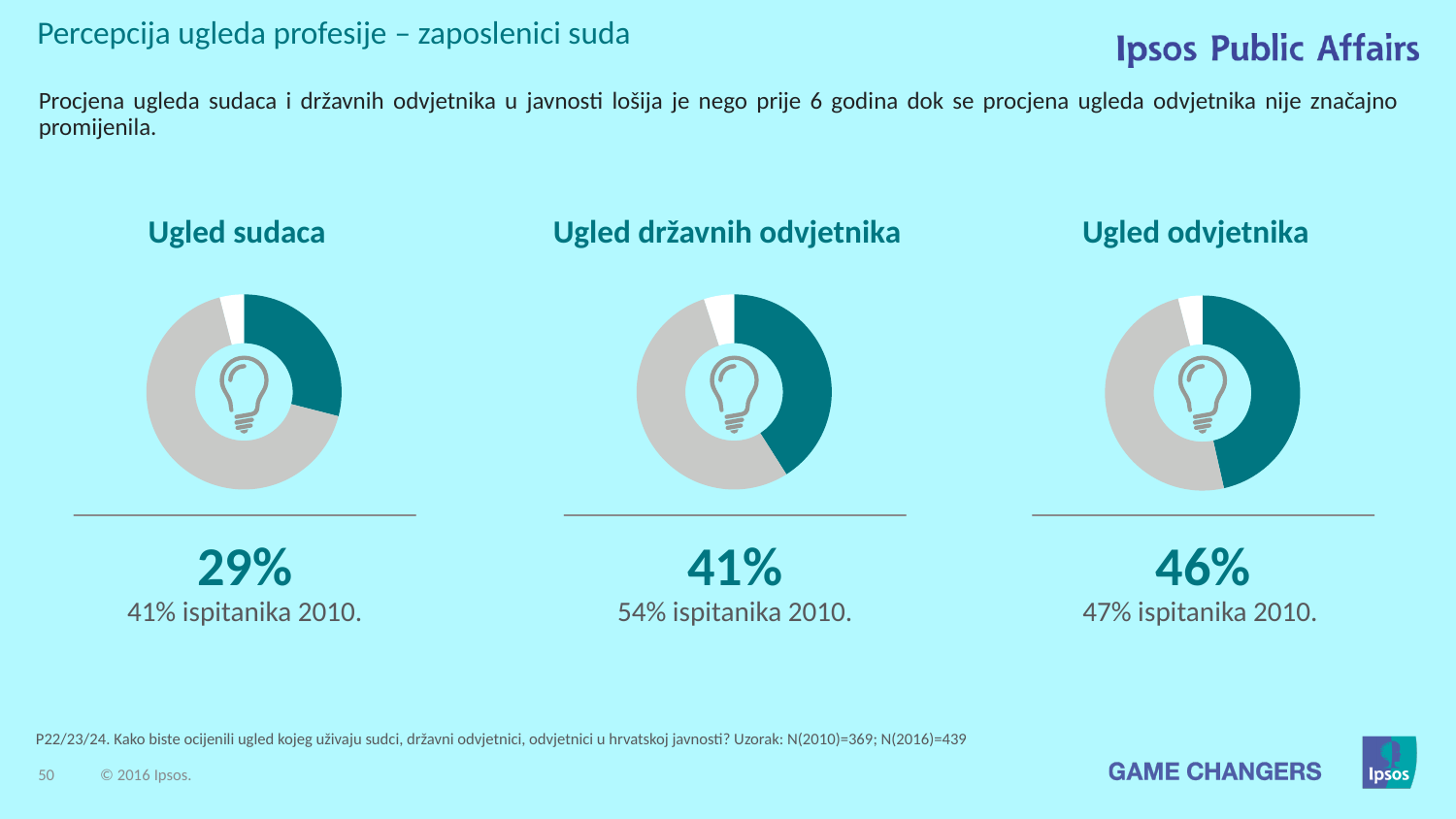
In the 'Ugled državnih odvjetnika' chart, what percentage is shown as the main value? 41% In the 'Ugled sudaca' chart, what was the percentage of respondents in 2010? 41% In the 'Ugled odvjetnika' chart, what was the percentage of respondents in 2010? 47% In the 'Ugled odvjetnika' chart, what percentage is shown as the main value? 46% Which of the three charts shows the highest main percentage? Ugled odvjetnika In the 'Ugled državnih odvjetnika' chart, what was the percentage of respondents in 2010? 54% Which of the three charts shows the lowest main percentage? Ugled sudaca In the 'Ugled sudaca' chart, by how many percentage points did the value drop from 2010 to the current value? 12 percentage points In the 'Ugled državnih odvjetnika' chart, what is the difference between the 2010 value and the current value? 13 percentage points What type of chart is used for the three charts on the slide? Donut (pie) chart In the 'Ugled sudaca' chart, what percentage is shown as the main value? 29% Which is larger: the main value in the 'Ugled sudaca' chart or the main value in the 'Ugled državnih odvjetnika' chart? Ugled državnih odvjetnika